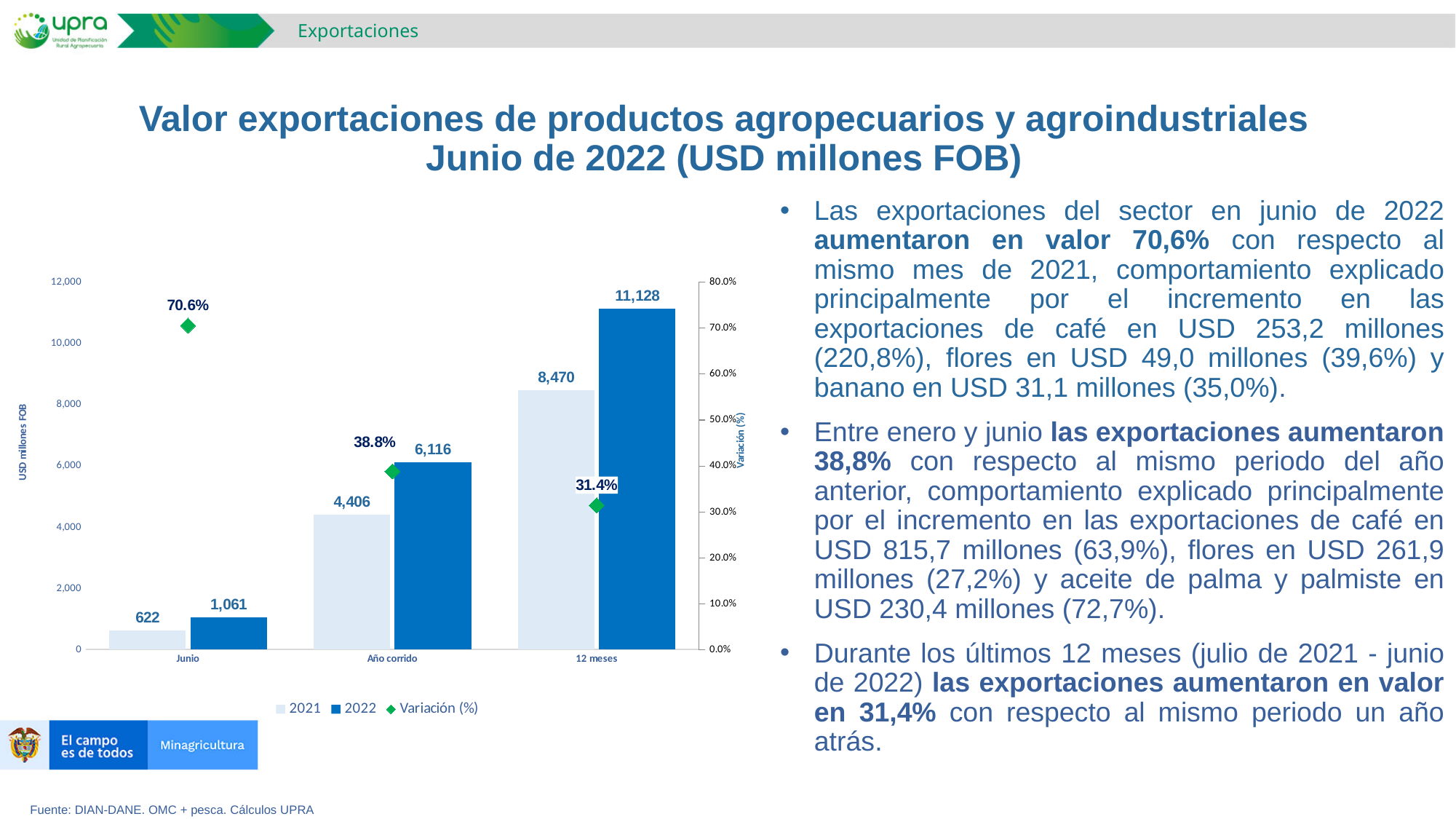
Which category has the highest Variación (%)? Junio What is the 2022 value for Junio? 1,061 What kind of chart is this? Bar chart with a line/marker series Which is larger, the 2022 value for Año corrido or the 2021 value for 12 meses? 2021 value for 12 meses Which category has the highest 2022 value? 12 meses What is the label of the left vertical axis? USD millones FOB How many categories are shown on the x axis? 3 What is the 2021 value for Año corrido? 4,406 What is the difference between the 2022 and 2021 values for 12 meses? 2,658 What is the Variación (%) value for 12 meses? 31.4% How many series does the legend list? 3 Which category has the lowest 2021 value? Junio